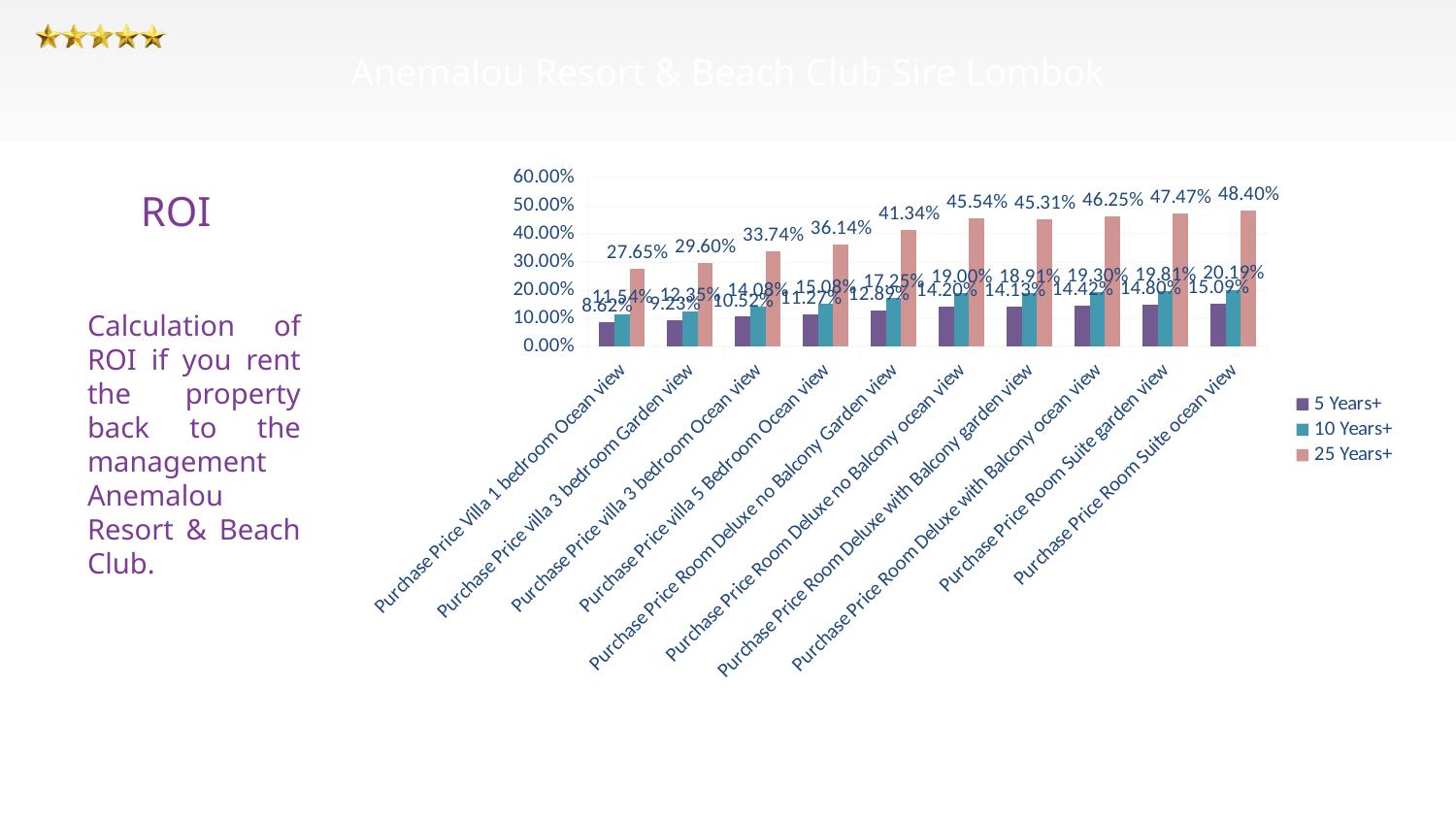
Which category has the highest 25 Years+ value? Purchase Price Room Suite ocean view What is the 5 Years+ value for Purchase Price Villa 1 bedroom Ocean view? 8.62% How many categories are plotted along the x axis of the chart? 10 Which has the larger 25 Years+ value: Purchase Price Room Deluxe no Balcony Garden view or Purchase Price Room Deluxe no Balcony ocean view? Purchase Price Room Deluxe no Balcony ocean view How many series does the chart legend list? 3 What is the difference between the 25 Years+ values for Purchase Price Room Suite ocean view and Purchase Price Villa 1 bedroom Ocean view? 20.75% What is the 25 Years+ value for Purchase Price Villa 1 bedroom Ocean view? 27.65% Is the 25 Years+ value for Purchase Price villa 5 Bedroom Ocean view greater or less than 40.00%? less What is the 10 Years+ value for Purchase Price Villa 1 bedroom Ocean view? 11.54% What is the 25 Years+ value for Purchase Price Room Suite ocean view? 48.40% What kind of chart is shown on the slide? Bar chart Which category has the lowest 25 Years+ value? Purchase Price Villa 1 bedroom Ocean view